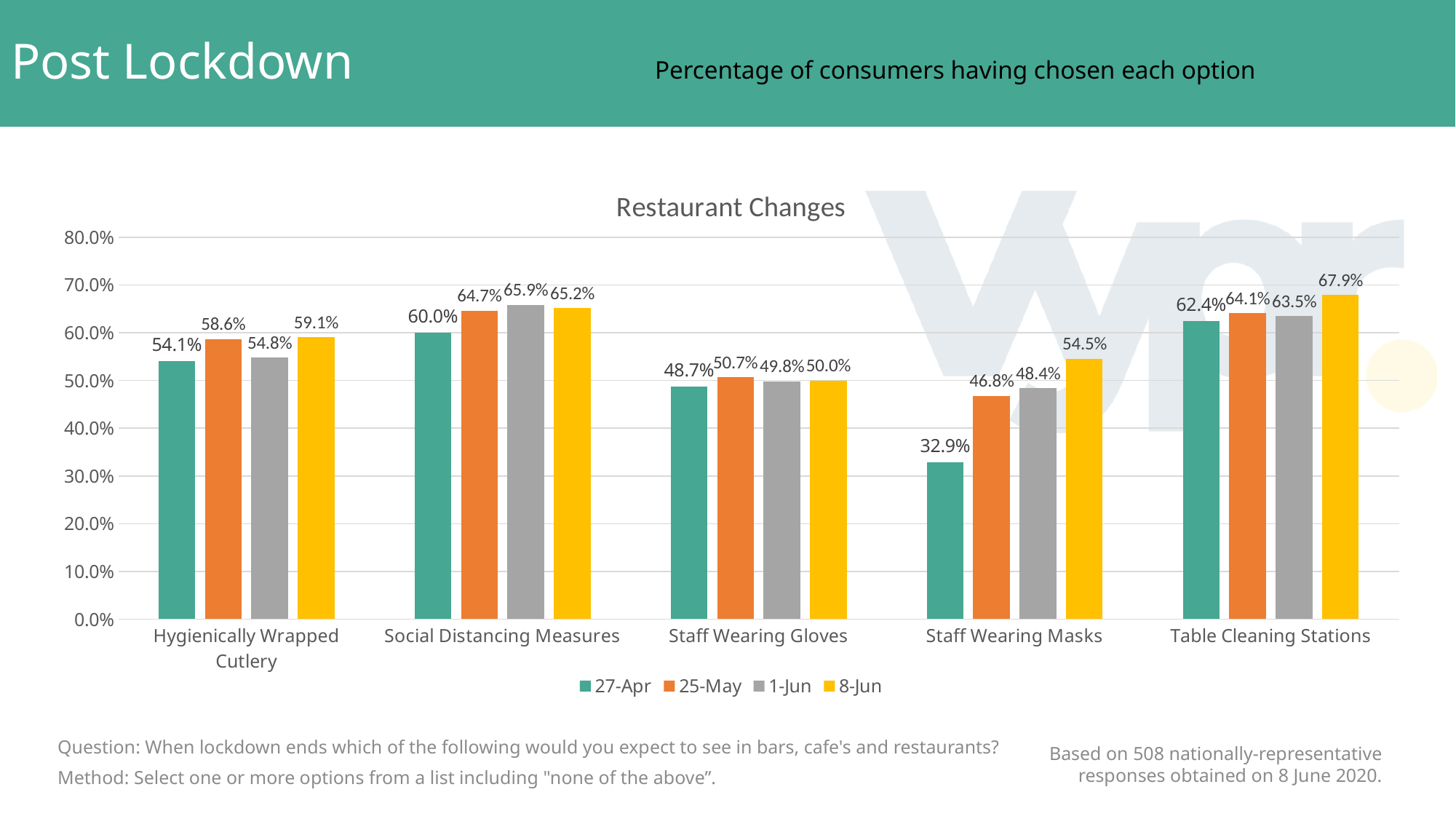
What is the value for Social Distancing Measures in the 1-Jun series? 65.9% Which category has the highest value in the 8-Jun series? Table Cleaning Stations Which category has the lowest value in the 27-Apr series? Staff Wearing Masks Do the values for Staff Wearing Masks rise or fall from 27-Apr to 8-Jun? Rise How many categories are shown on the x axis? 5 What is the value for Staff Wearing Masks in the 27-Apr series? 32.9% What is the difference between the 8-Jun and 27-Apr values for Staff Wearing Masks? 21.6% What is the value for Table Cleaning Stations in the 8-Jun series? 67.9% How many series does the legend list? 4 What is the title of the chart? Restaurant Changes Which is larger for Hygienically Wrapped Cutlery: the 25-May value or the 1-Jun value? 25-May What kind of chart is shown on the slide? Bar chart